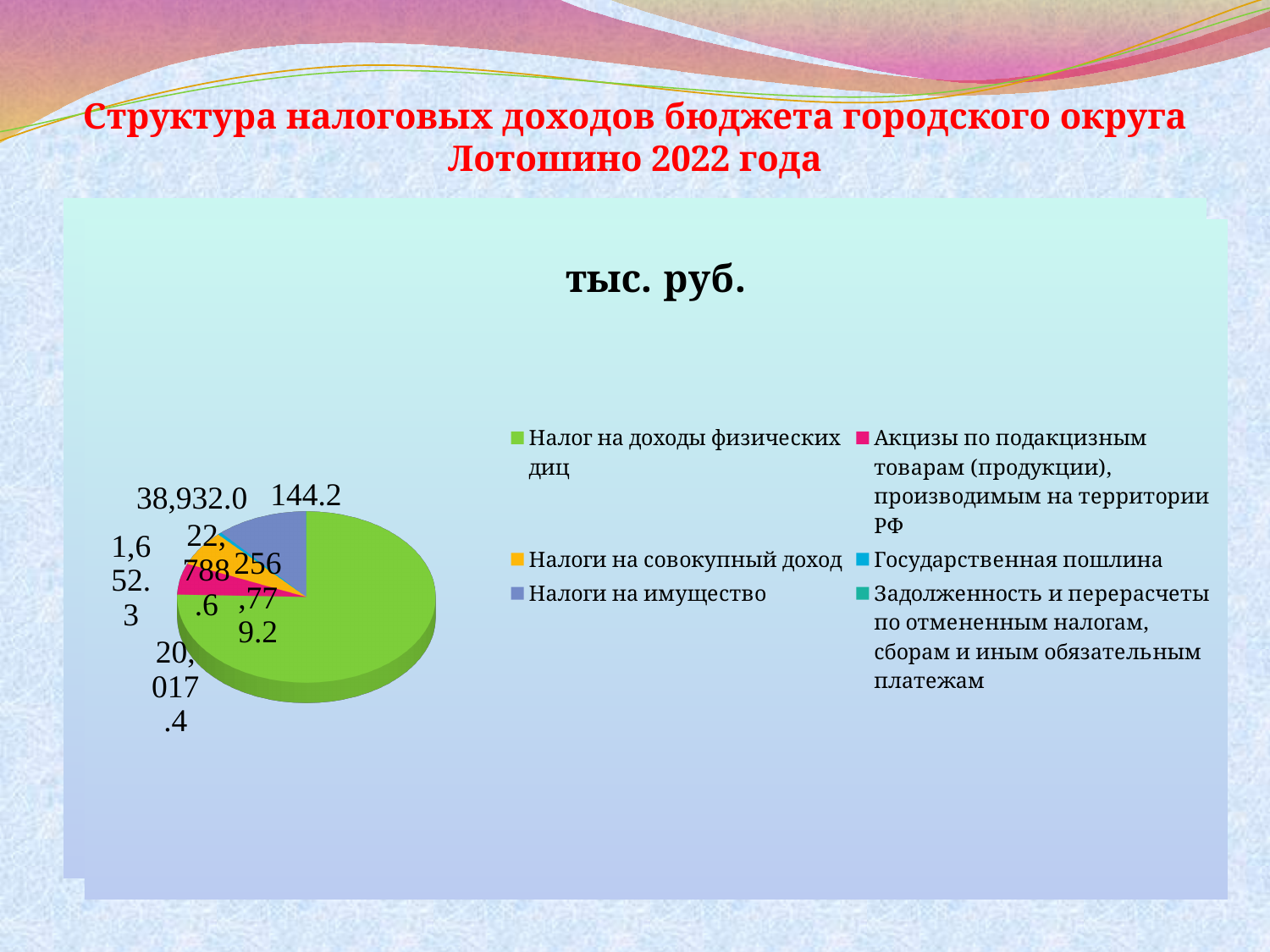
Which is larger in the pie chart: Налоги на имущество or Налоги на совокупный доход? Налоги на имущество Which category has the largest slice in the pie chart? Налог на доходы физических лиц What kind of chart is shown on the slide? Pie chart How many categories does the legend of the pie chart list? 6 What is the title shown above the pie chart? тыс. руб. What colour represents Налоги на имущество in the pie chart? Blue Does the slice for Налог на доходы физических лиц take up more or less than half of the pie? More Which is larger in the pie chart: Налог на доходы физических лиц or Налоги на имущество? Налог на доходы физических лиц